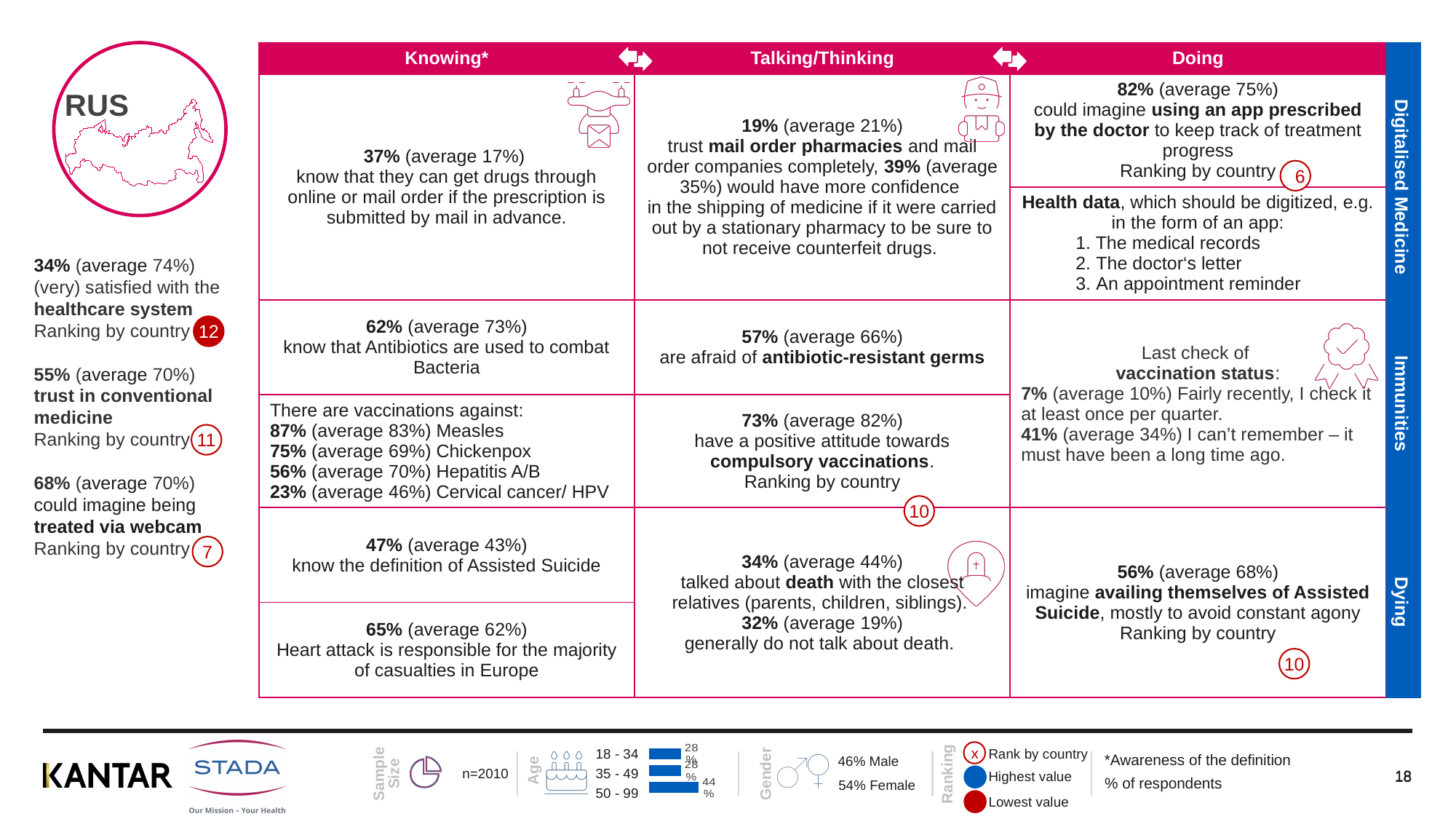
What kind of chart is the Age chart in the footer of the slide? bar chart In the Age bar chart in the footer, what is the value for the 35 - 49 age group? 28% In the Age bar chart in the footer, what is the value for the 18 - 34 age group? 28% In the Age bar chart in the footer, what is the value for the 50 - 99 age group? 44% In the Age bar chart in the footer, what is the difference between the value for 50 - 99 and the value for 35 - 49? 16 percentage points In the Age bar chart in the footer, which age group is listed first (at the top)? 18 - 34 In the Age bar chart in the footer, which age group has the highest value? 50 - 99 In the Age bar chart in the footer, are the bars drawn horizontally or vertically? horizontally In the Age bar chart in the footer, which is larger: the value for 50 - 99 or the value for 18 - 34? 50 - 99 In the Age bar chart in the footer, how many age groups are shown? 3